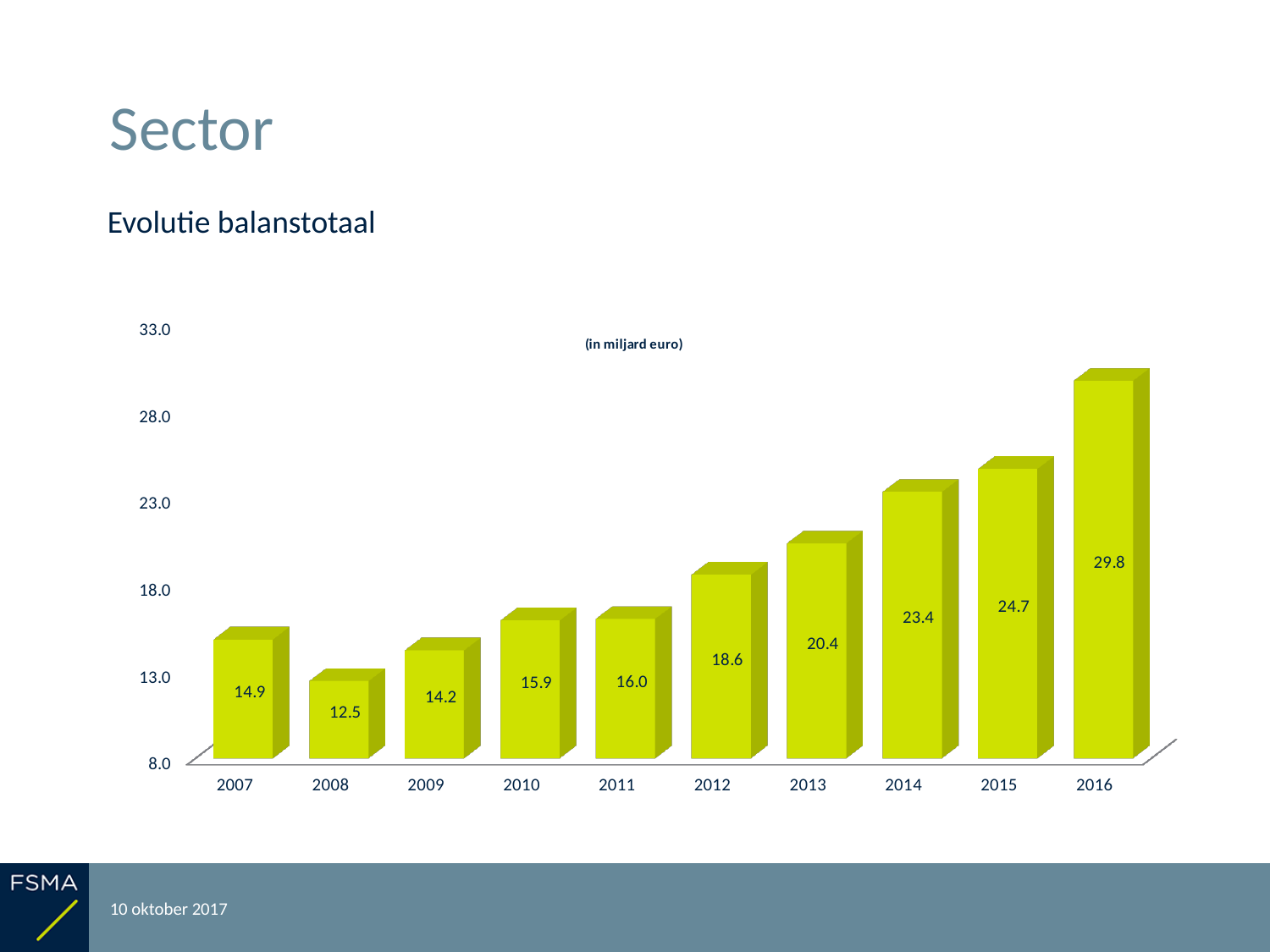
What is the value for 2012? 18.6 What kind of chart is this? bar chart Which is larger, the value for 2013 or the value for 2014? 2014 In what unit are the values expressed, according to the chart? in miljard euro Is the value for 2014 greater or less than 23.0? greater What is the value for 2016? 29.8 Which year has the highest value? 2016 How many years are shown on the x axis? 10 What is the value for 2007? 14.9 What is the difference between the values for 2016 and 2015? 5.1 Which year has the lowest value? 2008 What is the difference between the values for 2008 and 2007? 2.4